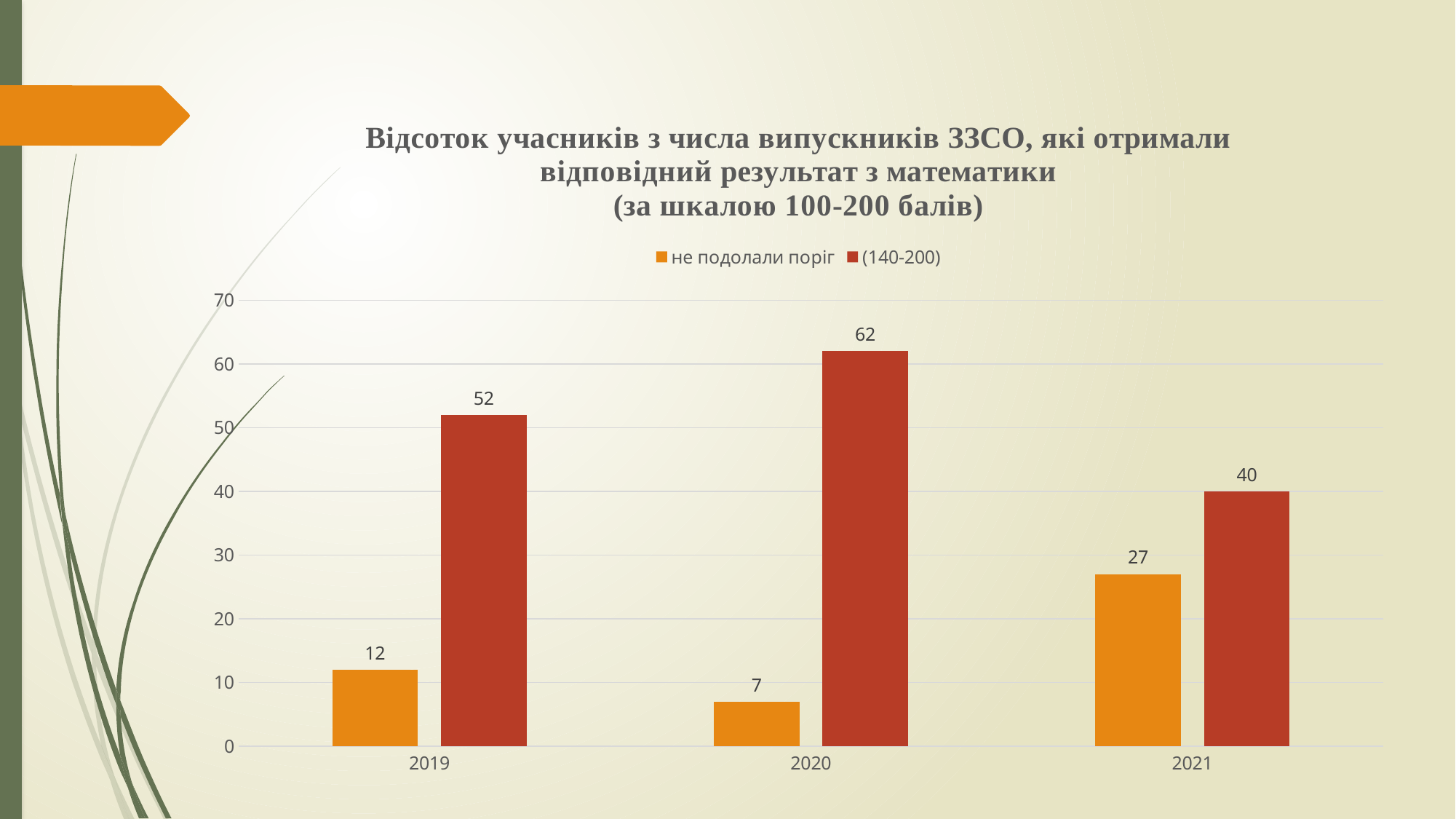
Which is larger in 2019: "не подолали поріг" or "(140-200)"? (140-200) What is the value for "не подолали поріг" in 2019? 12 What colour are the bars for the "не подолали поріг" series? Orange Which year has the highest value for "(140-200)"? 2020 How many series does the legend list? 2 Which year has the lowest value for "не подолали поріг"? 2020 How many years are shown on the x axis? 3 Does the "(140-200)" series rise or fall from 2020 to 2021? Fall What is the value for "не подолали поріг" in 2021? 27 What kind of chart is shown on the slide? Bar chart What is the value for "(140-200)" in 2020? 62 What is the difference between the "(140-200)" values for 2020 and 2021? 22